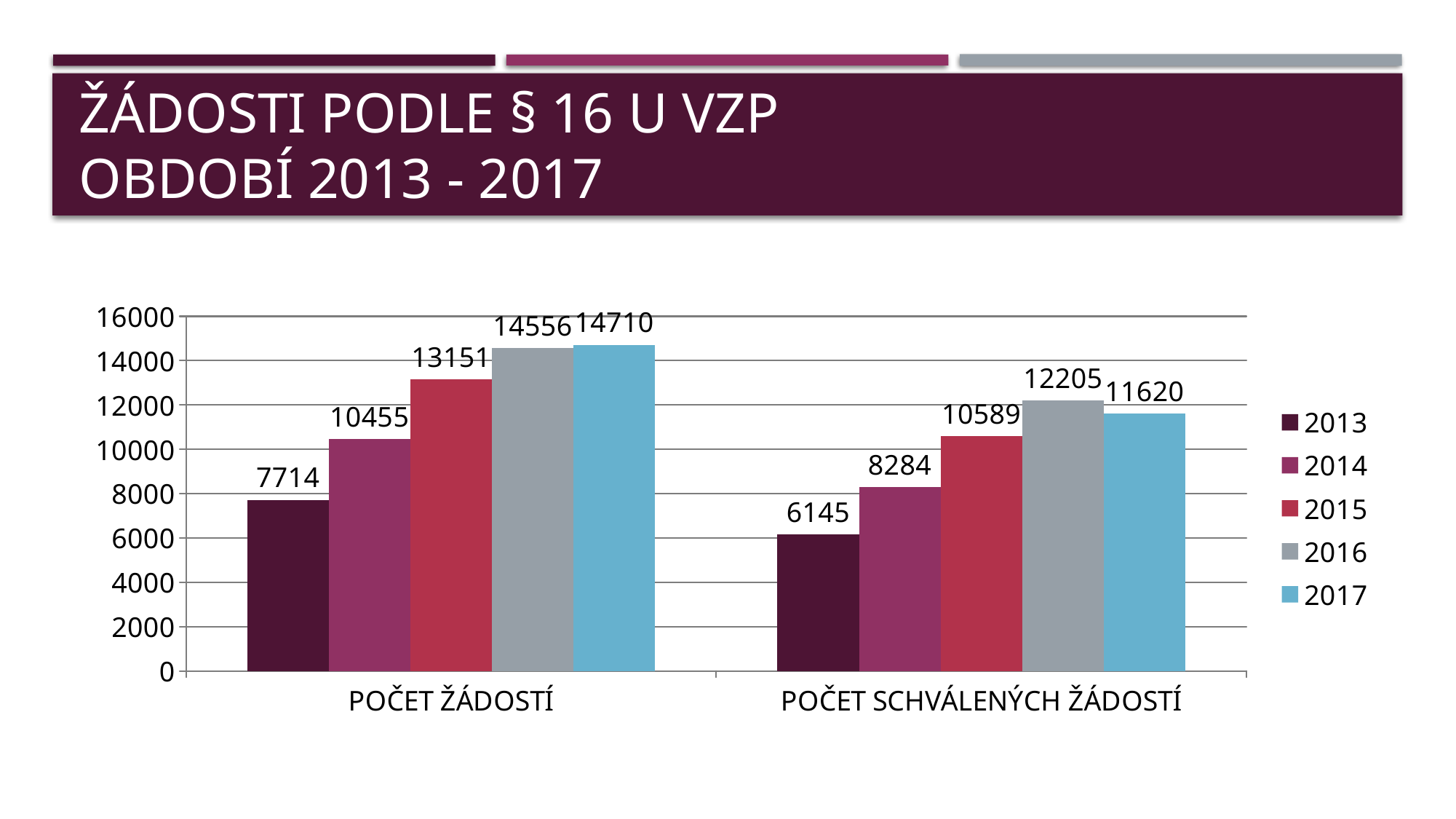
Is the 2014 value for POČET SCHVÁLENÝCH ŽÁDOSTÍ greater or less than 10000? less What is the value for 2015 in the POČET ŽÁDOSTÍ category? 13151 What is the difference between the 2016 and 2017 values in the POČET SCHVÁLENÝCH ŽÁDOSTÍ category? 585 How many categories are shown on the x axis? 2 What is the value for 2013 in the POČET SCHVÁLENÝCH ŽÁDOSTÍ category? 6145 Which year has the lowest value in the POČET ŽÁDOSTÍ category? 2013 Which year has the highest value in the POČET SCHVÁLENÝCH ŽÁDOSTÍ category? 2016 What is the difference between the POČET ŽÁDOSTÍ and POČET SCHVÁLENÝCH ŽÁDOSTÍ values for 2014? 2171 What kind of chart is shown on the slide? bar chart What is the value for 2017 in the POČET ŽÁDOSTÍ category? 14710 Which is larger: the 2015 value for POČET ŽÁDOSTÍ or the 2016 value for POČET SCHVÁLENÝCH ŽÁDOSTÍ? 2015 value for POČET ŽÁDOSTÍ How many series does the legend list? 5